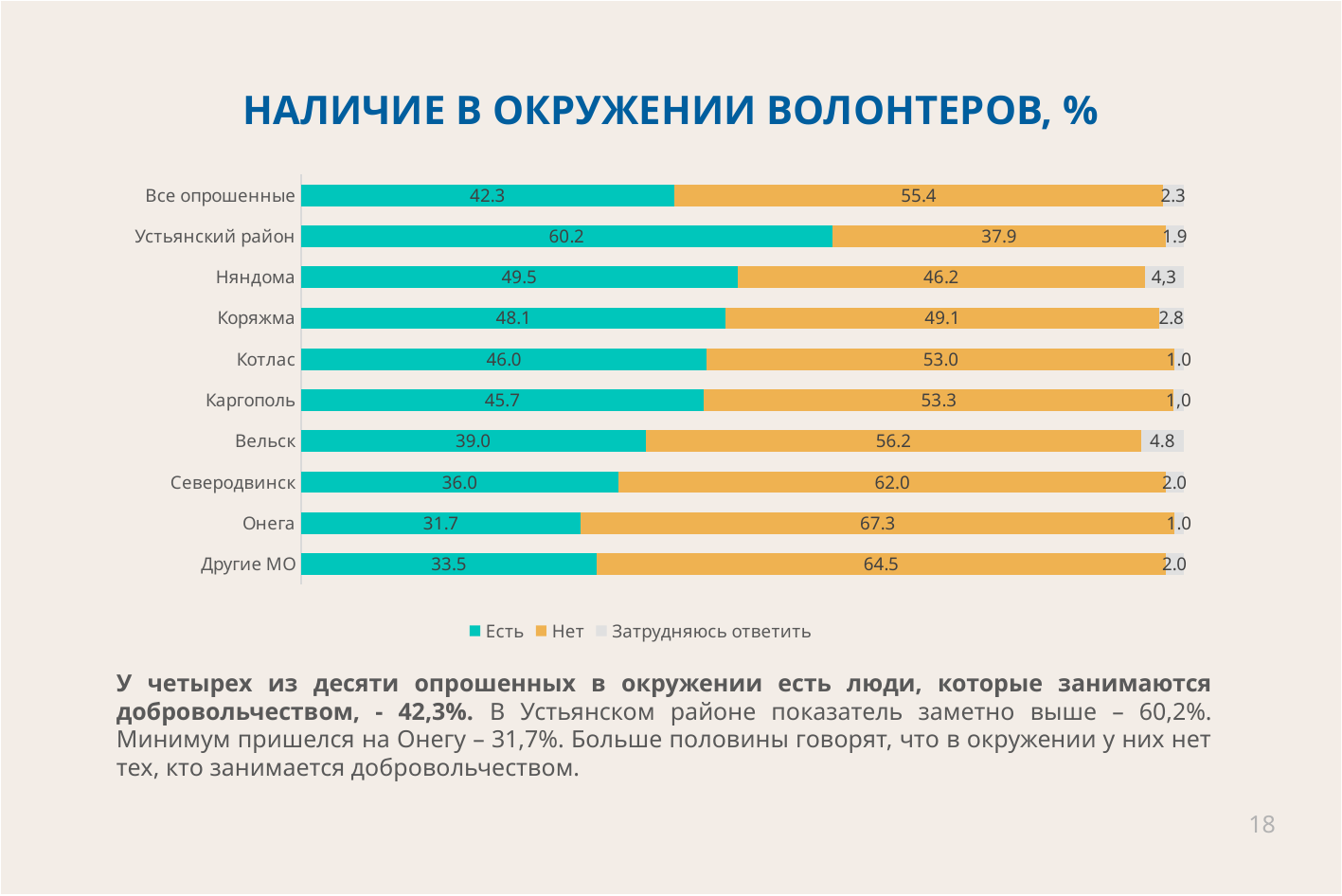
What kind of chart is shown on the slide? Stacked bar chart Which category has the lowest value for «Есть»? Онега What is the value of «Есть» for Устьянский район? 60.2 How many series does the legend list? 3 How many categories are shown on the chart? 10 What is the value of «Затрудняюсь ответить» for Вельск? 4.8 What is the value of «Нет» for Онега? 67.3 What are the three legend entries of the chart? Есть, Нет, Затрудняюсь ответить Which category has the highest value for «Есть»? Устьянский район Which has a larger «Нет» value, Северодвинск or Вельск? Северодвинск What is the total of the stacked bar for Котлас? 100.0 What is the difference between the «Есть» value for Устьянский район and for Все опрошенные? 17.9